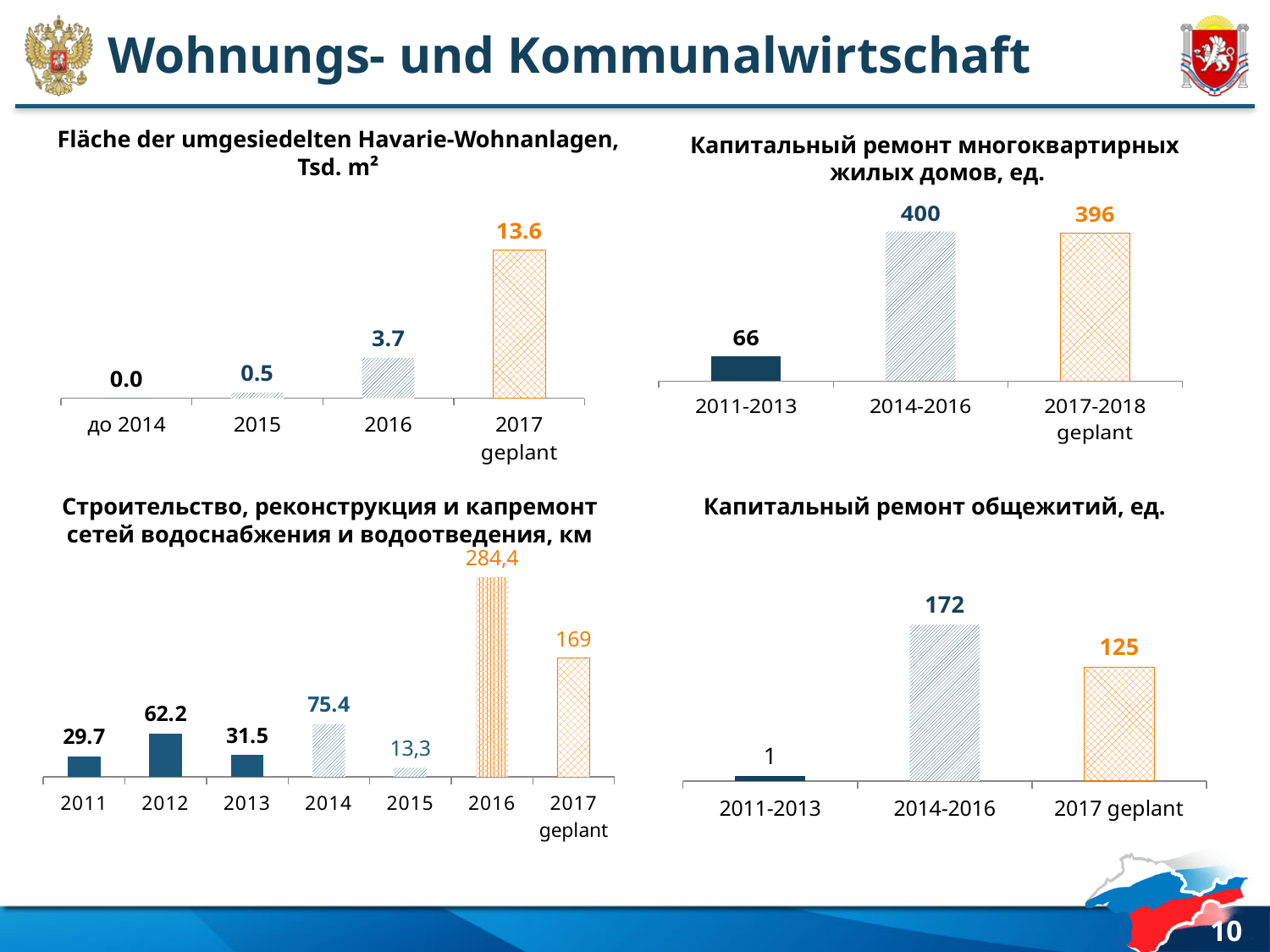
In the top-left chart (Fläche der umgesiedelten Havarie-Wohnanlagen), which category has the highest value? 2017 geplant In the top-right chart (Капитальный ремонт многоквартирных жилых домов), which category has the lowest value? 2011-2013 In the bottom-left chart (Строительство, реконструкция и капремонт сетей водоснабжения и водоотведения), how many categories are shown on the x axis? 7 In the top-right chart (Капитальный ремонт многоквартирных жилых домов), what is the difference between the values for 2014-2016 and 2017-2018 geplant? 4 In the bottom-right chart (Капитальный ремонт общежитий), what is the value for 2014-2016? 172 In the top-left chart (Fläche der umgesiedelten Havarie-Wohnanlagen), what is the value for 2016? 3.7 In the top-right chart (Капитальный ремонт многоквартирных жилых домов), what is the value for 2011-2013? 66 In the bottom-left chart (Строительство, реконструкция и капремонт сетей водоснабжения и водоотведения), which year has the lowest value? 2015 In the top-left chart (Fläche der umgesiedelten Havarie-Wohnanlagen), how many categories are shown on the x axis? 4 In the bottom-left chart (Строительство, реконструкция и капремонт сетей водоснабжения и водоотведения), what is the value for 2016? 284,4 What kind of chart is the bottom-right chart (Капитальный ремонт общежитий)? Bar chart In the bottom-left chart (Строительство, реконструкция и капремонт сетей водоснабжения и водоотведения), which is larger, the value for 2012 or the value for 2013? 2012